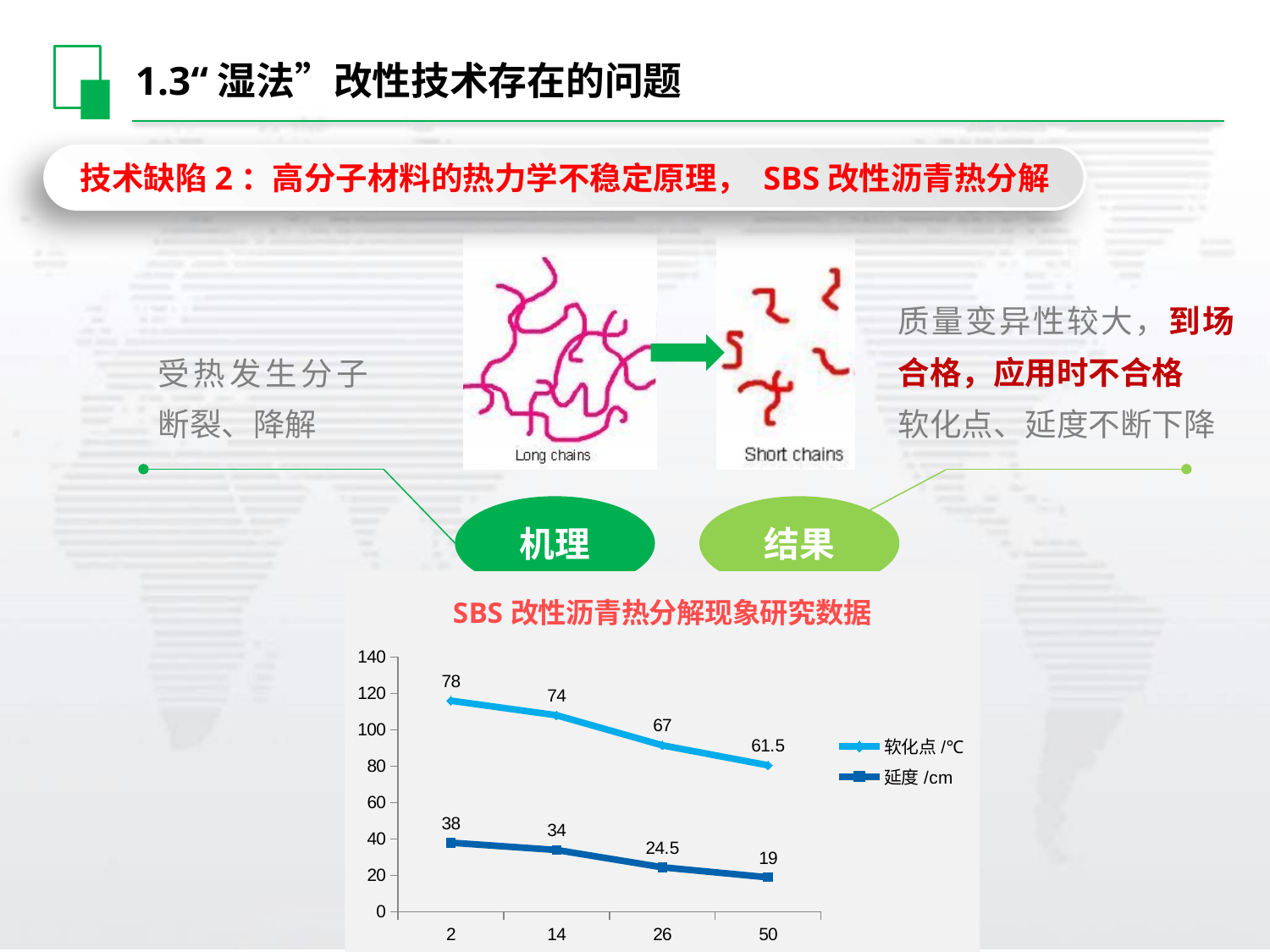
How many series does the chart legend list? 2 What is the value of 软化点 /℃ at x = 50? 61.5 What is the value of 延度 /cm at x = 50? 19 What is the difference between the 软化点 /℃ values at x = 2 and x = 50? 16.5 At which x value is 软化点 /℃ lowest? 50 What type of chart is shown on the slide? line chart What is the value of 延度 /cm at x = 26? 24.5 At which x value is 延度 /cm highest? 2 What is the title of the chart? SBS 改性沥青热分解现象研究数据 What is the value of 软化点 /℃ at x = 2? 78 Do the 延度 /cm values rise or fall as x increases from 2 to 50? fall How many points are plotted along the x axis for each series? 4